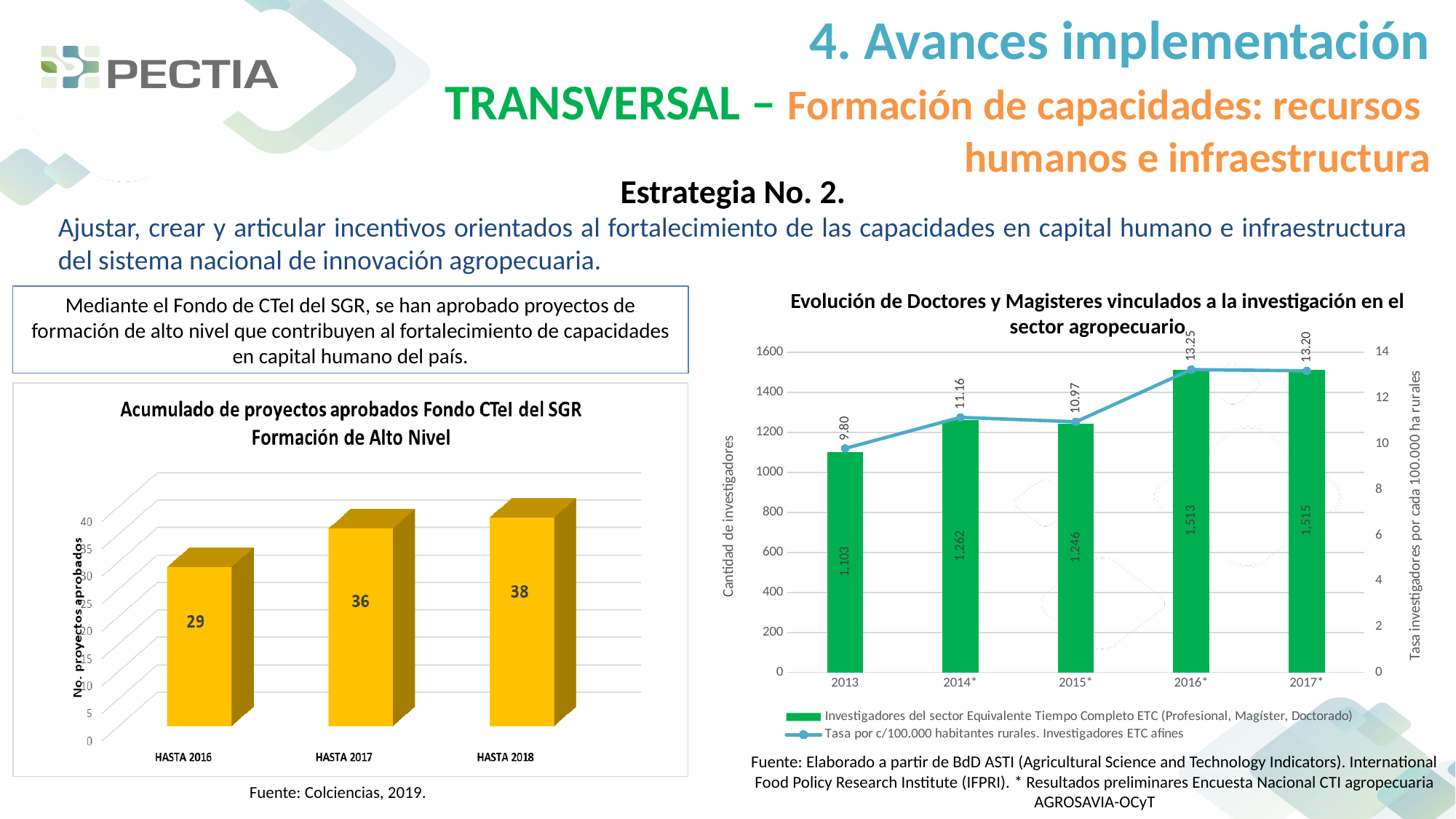
In the chart 'Evolución de Doctores y Magisteres vinculados a la investigación en el sector agropecuario', how many series does the legend list? 2 In the chart 'Acumulado de proyectos aprobados Fondo CTeI del SGR Formación de Alto Nivel', which category has the lowest value? HASTA 2016 In the chart 'Acumulado de proyectos aprobados Fondo CTeI del SGR Formación de Alto Nivel', how many categories are shown? 3 In the chart 'Evolución de Doctores y Magisteres vinculados a la investigación en el sector agropecuario', which year has the lowest number of investigadores ETC? 2013 In the chart 'Acumulado de proyectos aprobados Fondo CTeI del SGR Formación de Alto Nivel', what is the difference between HASTA 2018 and HASTA 2016? 9 In the chart 'Evolución de Doctores y Magisteres vinculados a la investigación en el sector agropecuario', what is the difference in investigadores ETC between 2016* and 2013? 410 In the chart 'Evolución de Doctores y Magisteres vinculados a la investigación en el sector agropecuario', what is the 'Tasa por c/100.000 habitantes rurales' for 2015*? 10.97 In the chart 'Evolución de Doctores y Magisteres vinculados a la investigación en el sector agropecuario', which is larger, the number of investigadores ETC in 2014* or in 2015*? 2014* What type of chart is 'Acumulado de proyectos aprobados Fondo CTeI del SGR Formación de Alto Nivel'? bar chart In the chart 'Evolución de Doctores y Magisteres vinculados a la investigación en el sector agropecuario', what is the number of investigadores ETC for 2013? 1,103 In the chart 'Acumulado de proyectos aprobados Fondo CTeI del SGR Formación de Alto Nivel', what is the value for HASTA 2017? 36 In the chart 'Acumulado de proyectos aprobados Fondo CTeI del SGR Formación de Alto Nivel', do the values rise or fall from HASTA 2016 to HASTA 2018? rise